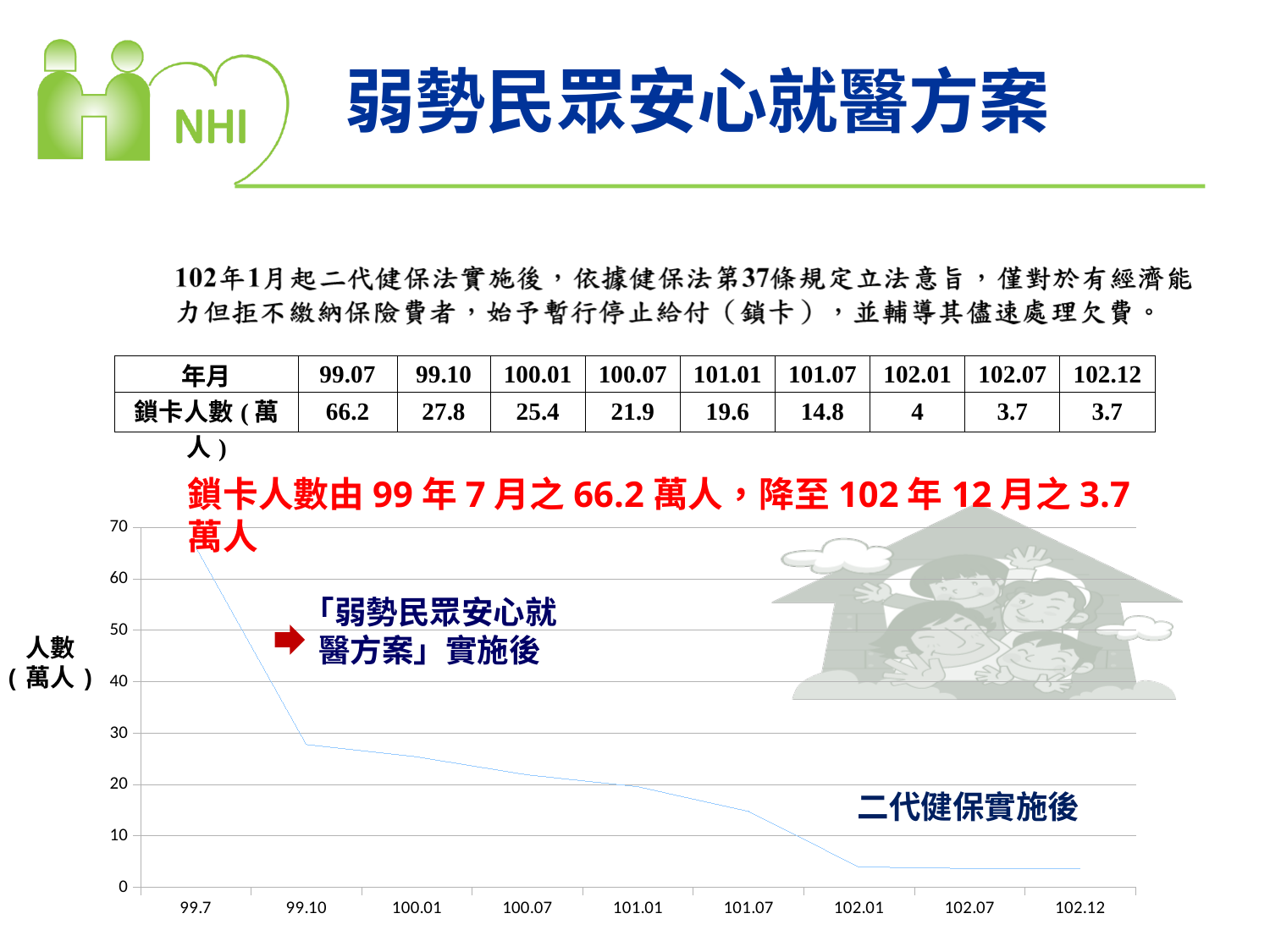
Which period has the highest 鎖卡人數? 99.07 What is the value (鎖卡人數, 萬人) for 102.01? 4 What is the label on the y axis of the chart? 人數（萬人） Do the values rise or fall along the x axis from 99.07 to 102.12? fall Is the value for 99.10 greater or less than 30? less What is the value (鎖卡人數, 萬人) for 99.07? 66.2 What is the difference in 鎖卡人數 between 99.07 and 99.10? 38.4 What is the value (鎖卡人數, 萬人) for 101.07? 14.8 What is the difference in 鎖卡人數 between 100.07 and 101.01? 2.3 How many data points are plotted on the line chart? 9 Which is larger, the value for 100.01 or the value for 101.01? 100.01 What kind of chart is shown on the slide? line chart